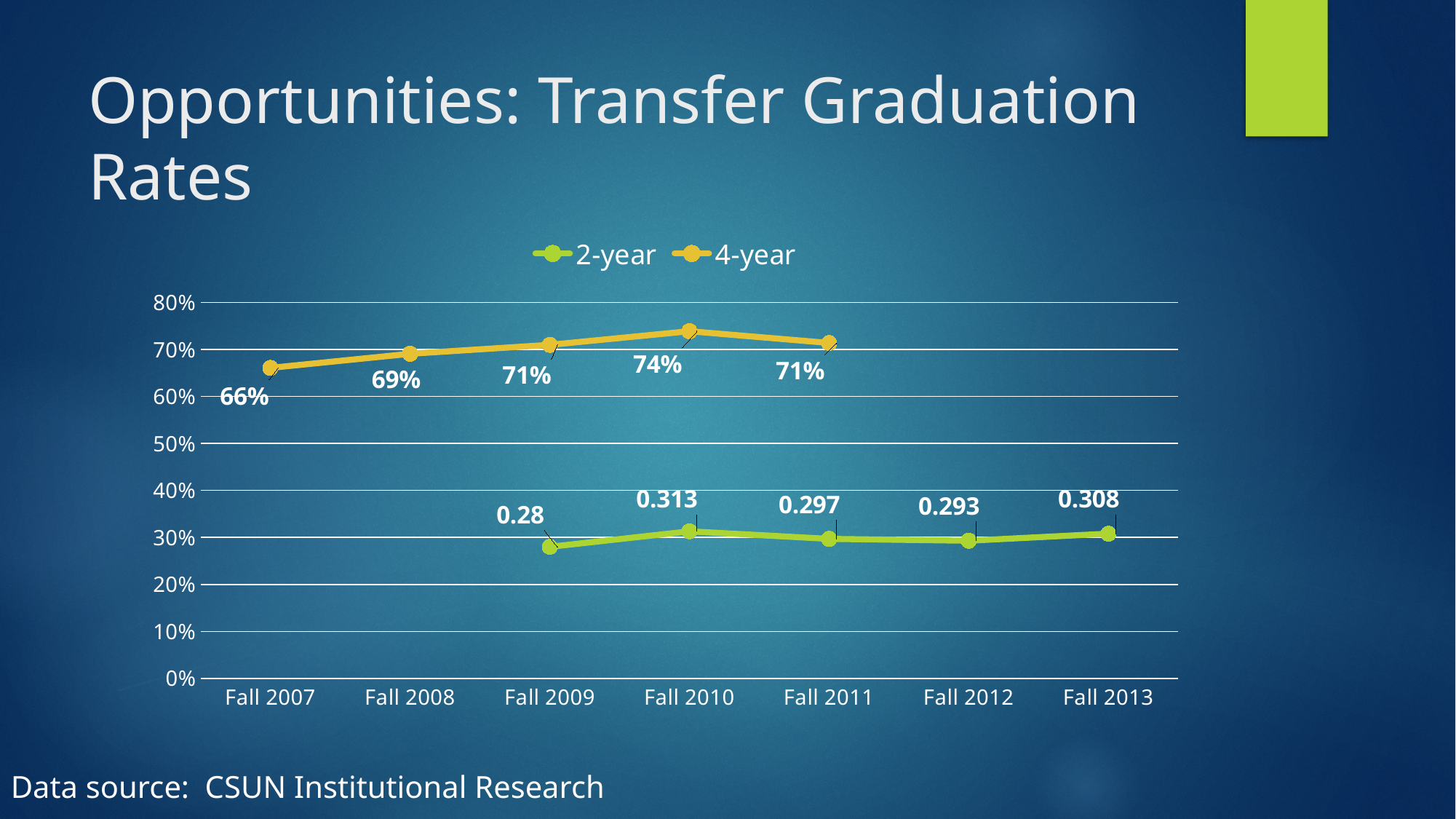
In which term is the 4-year graduation rate highest? Fall 2010 Does the 4-year graduation rate rise or fall from Fall 2007 to Fall 2010? Rise What is the 2-year value shown for Fall 2009? 0.28 What is the 2-year value shown for Fall 2013? 0.308 How many terms are labelled on the x axis? 7 How many series does the legend list? 2 What is the 4-year graduation rate for Fall 2007? 66% What kind of chart is shown on the slide? Line chart In which term is the 2-year value lowest? Fall 2009 What is the 4-year graduation rate for Fall 2010? 74% What is the difference between the 4-year rates for Fall 2010 and Fall 2007? 8% Which is larger, the 2-year value for Fall 2010 or for Fall 2012? Fall 2010